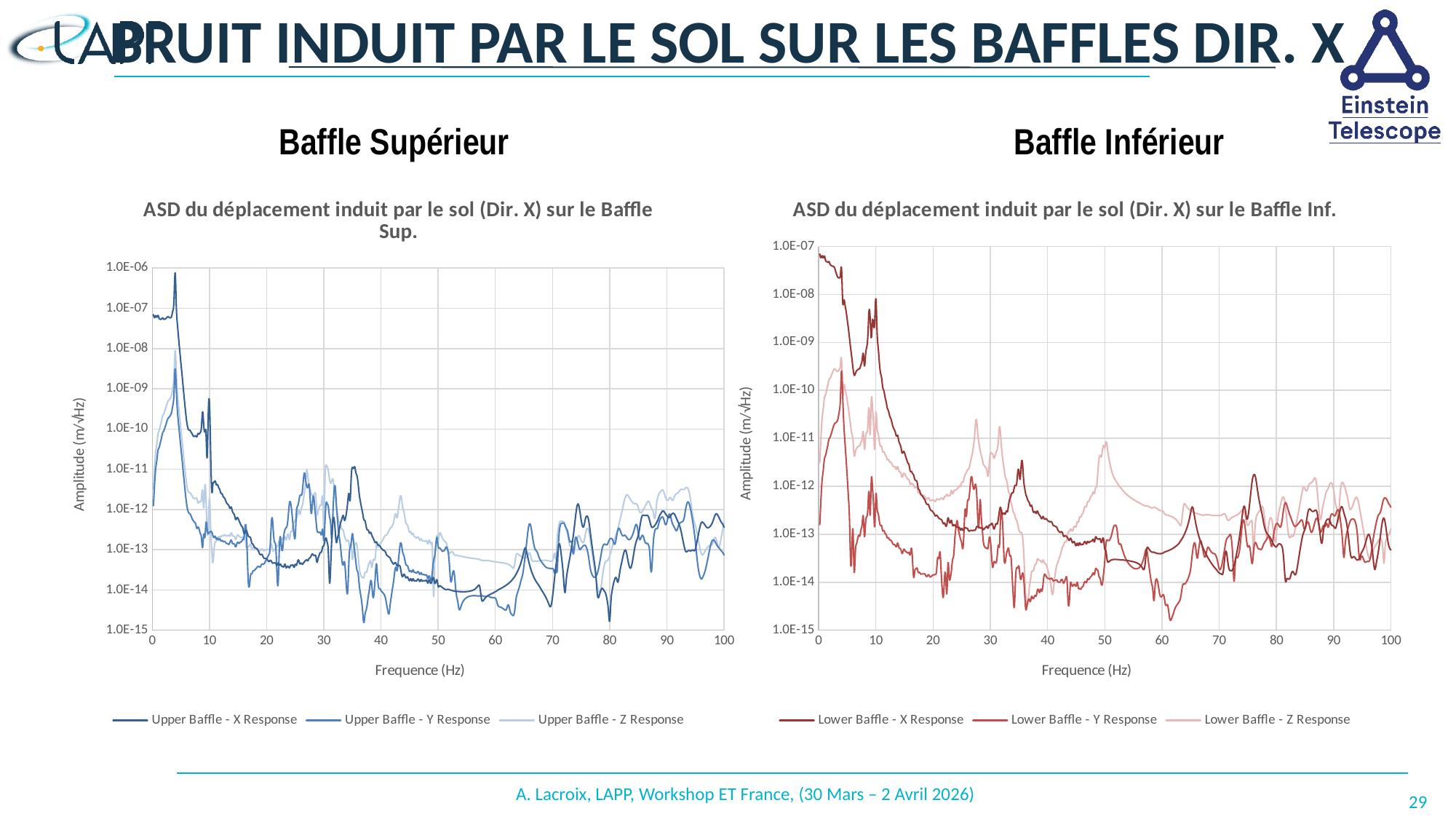
What is the x-axis label of the left chart (Baffle Sup.)? Frequence (Hz) In the left chart (Baffle Sup.), which series reaches the highest amplitude? Upper Baffle - X Response What kind of chart is the left chart titled 'ASD du déplacement induit par le sol (Dir. X) sur le Baffle Sup.'? Line chart In the right chart (Baffle Inf.), does Lower Baffle - X Response rise or fall overall between 10 Hz and 40 Hz? fall In the right chart (Baffle Inf.), is the peak value of Lower Baffle - X Response near 10 Hz greater or less than 1.0E-09? greater How many series does the legend of the right chart (Baffle Inf.) list? 3 What is the y-axis label of the right chart (Baffle Inf.)? Amplitude (m/√Hz) In the right chart (Baffle Inf.), which series reaches the highest amplitude? Lower Baffle - X Response How many series does the legend of the left chart (Baffle Sup.) list? 3 In the right chart (Baffle Inf.), is the peak of Lower Baffle - Z Response near 50 Hz greater or less than 1.0E-12? greater In the left chart (Baffle Sup.), is the value of Upper Baffle - X Response at 35 Hz greater or less than 1.0E-12? greater